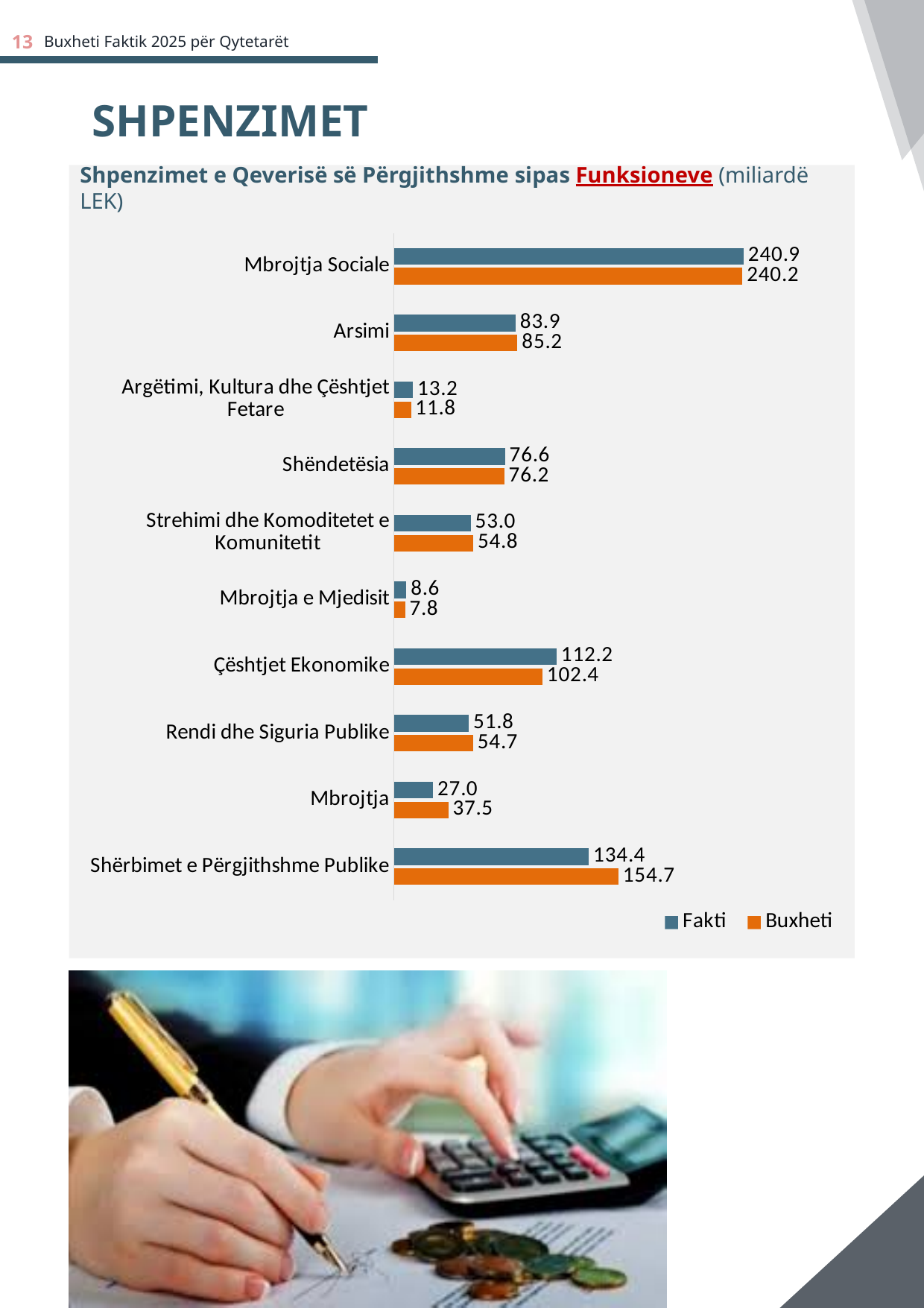
How many categories are shown in the chart? 10 What is the difference between the Buxheti and Fakti values for Shërbimet e Përgjithshme Publike? 20.3 What kind of chart is shown on the slide? Bar chart What is the Buxheti value for Mbrojtja? 37.5 Which is larger: the Fakti value for Arsimi or the Fakti value for Shëndetësia? Arsimi How many series does the legend list? 2 What is the difference between the Buxheti and Fakti values for Çështjet Ekonomike? 9.8 What is the Buxheti value for Shërbimet e Përgjithshme Publike? 154.7 What is the Fakti value for Mbrojtja Sociale? 240.9 Which category has the highest Fakti value? Mbrojtja Sociale Which category has the lowest Buxheti value? Mbrojtja e Mjedisit For Mbrojtja, which is larger: the Fakti value or the Buxheti value? Buxheti